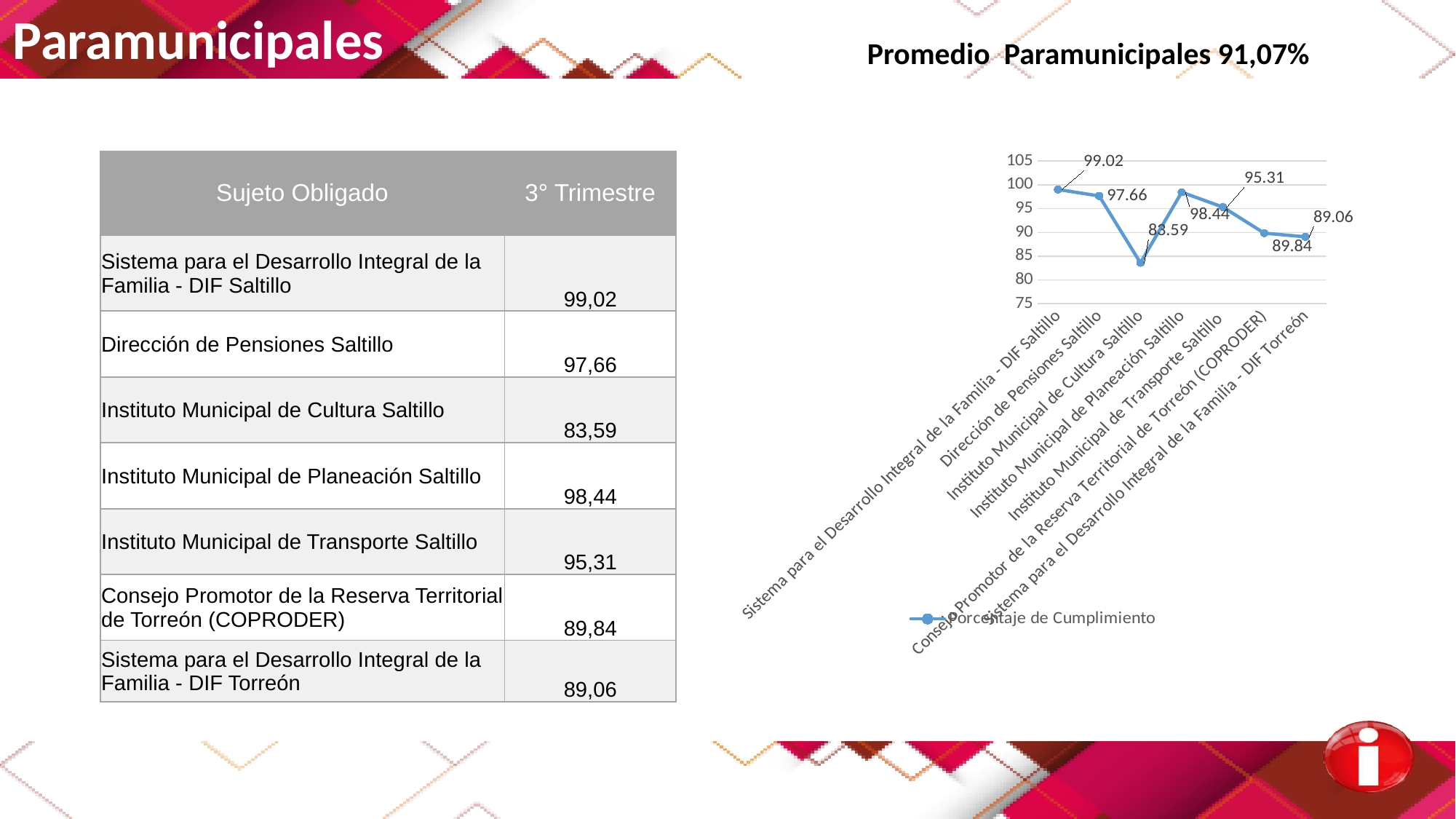
Is the value for Instituto Municipal de Cultura Saltillo greater or less than 85? less Which category has the highest value on the chart? Sistema para el Desarrollo Integral de la Familia - DIF Saltillo Which category has the lowest value on the chart? Instituto Municipal de Cultura Saltillo What is the value plotted for Instituto Municipal de Cultura Saltillo? 83.59 What type of chart is shown on the slide? line chart What is the value plotted for Instituto Municipal de Transporte Saltillo? 95.31 Which is larger, the value for Dirección de Pensiones Saltillo or the value for Consejo Promotor de la Reserva Territorial de Torreón (COPRODER)? Dirección de Pensiones Saltillo How many data points are plotted on the line chart? 7 How many series does the chart legend list? 1 What is the difference between the values for Instituto Municipal de Planeación Saltillo and Instituto Municipal de Cultura Saltillo? 14.85 What is the name of the series shown in the chart legend? Porcentaje de Cumplimiento What is the value plotted for Sistema para el Desarrollo Integral de la Familia - DIF Torreón? 89.06